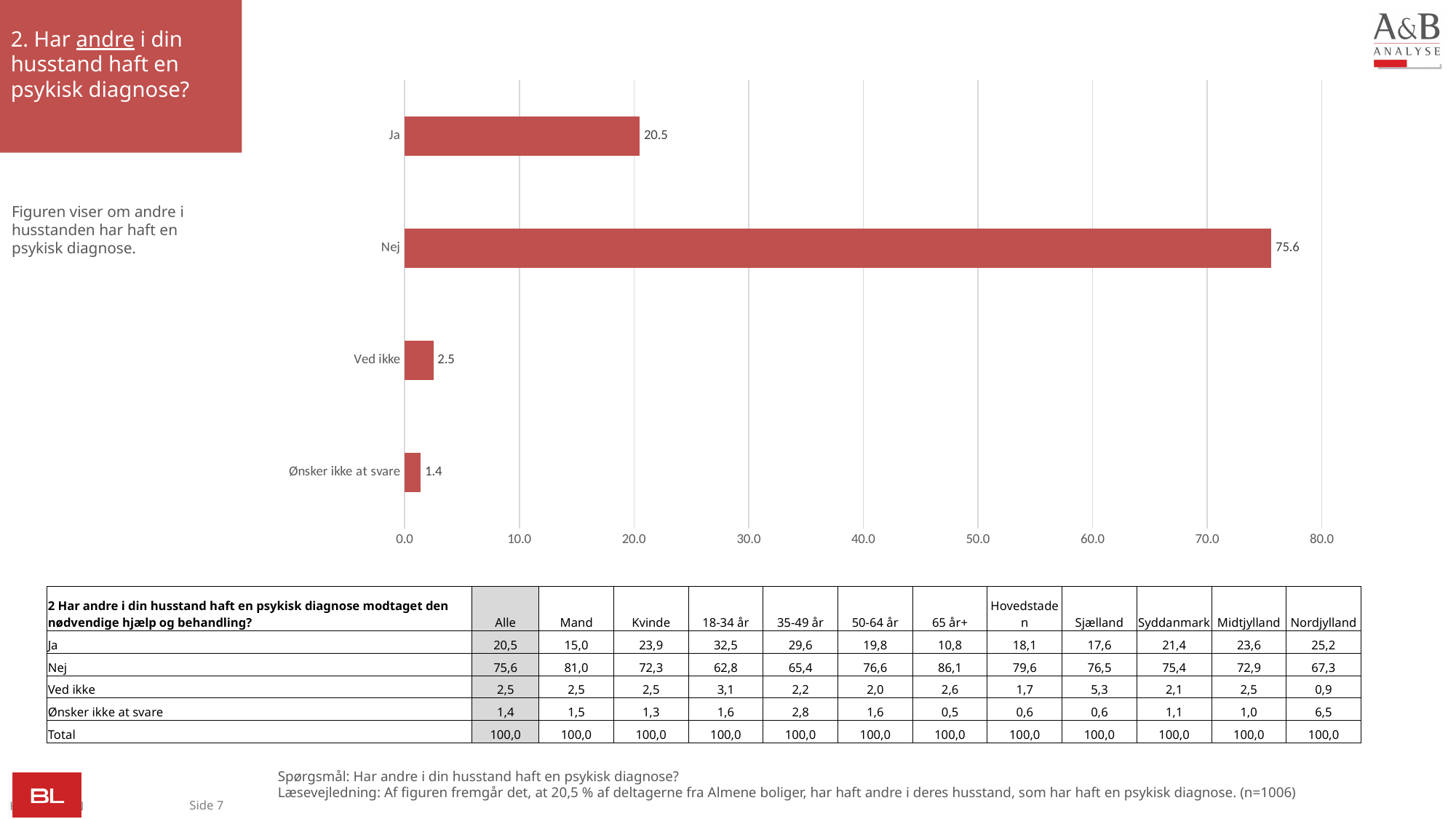
What is the value for "Nej" in the bar chart? 75.6 What is the highest value shown on the x axis of the bar chart? 80.0 Is the value for "Nej" in the bar chart greater or less than 70.0? greater What kind of chart is shown on the slide? Bar chart What is the difference between the values for "Nej" and "Ja" in the bar chart? 55.1 Which category has the lowest value in the bar chart? Ønsker ikke at svare Which is larger in the bar chart, the value for "Ja" or the value for "Ved ikke"? Ja How many categories are shown in the bar chart? 4 Which category has the highest value in the bar chart? Nej What is the value for "Ja" in the bar chart? 20.5 What is the value for "Ønsker ikke at svare" in the bar chart? 1.4 What is the value for "Ved ikke" in the bar chart? 2.5